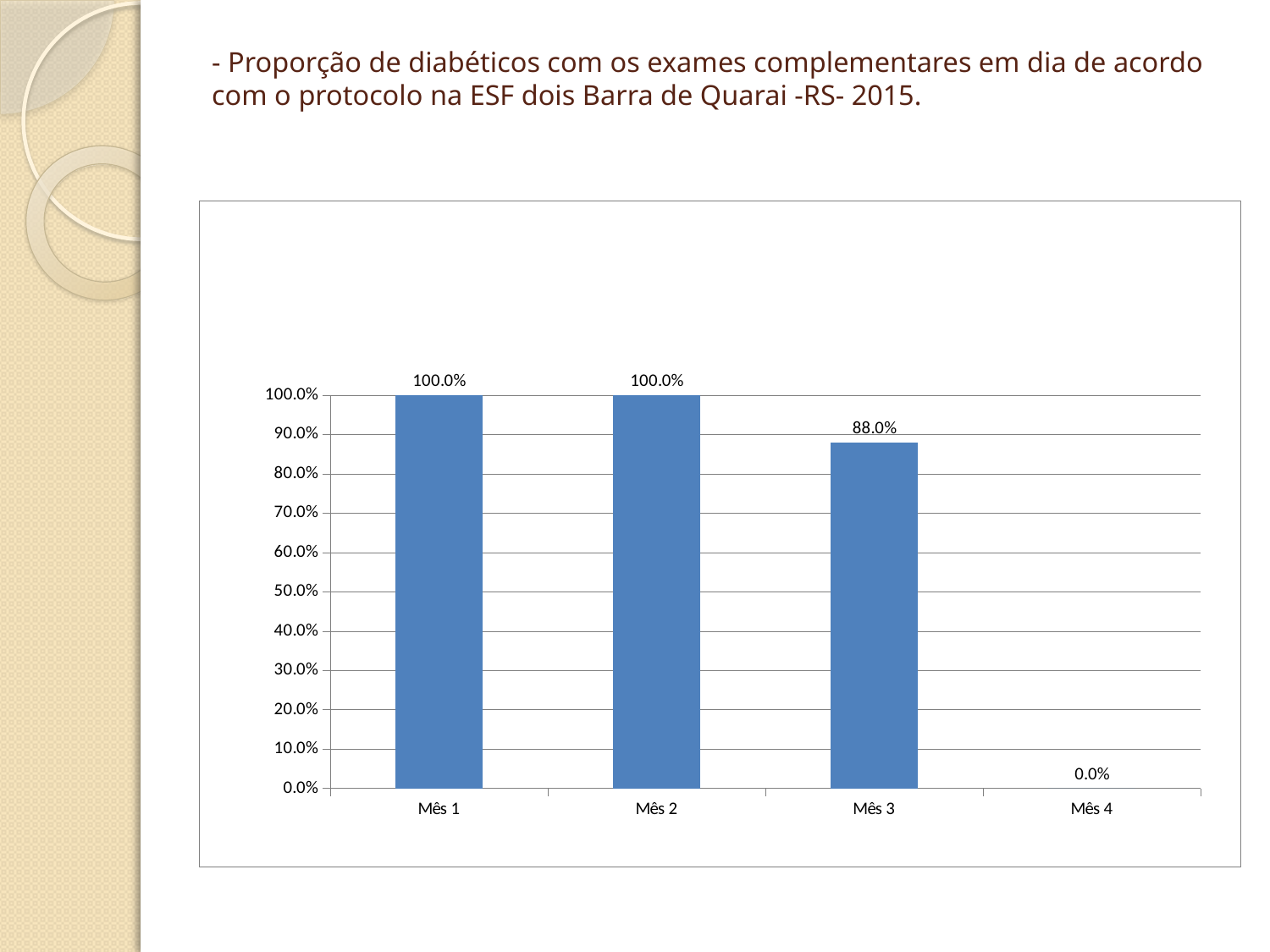
What is the value for Mês 3? 88.0% How many categories are shown on the x axis? 4 What is the difference between the values for Mês 2 and Mês 3? 12.0% Which is larger, the value for Mês 1 or the value for Mês 3? Mês 1 What is the value for Mês 1? 100.0% Do the values rise or fall from Mês 2 to Mês 4? fall Which category has the lowest value? Mês 4 Is the value for Mês 3 greater or less than 80.0%? greater What colour are the bars in the chart? blue What is the value for Mês 4? 0.0% What kind of chart is shown on the slide? bar chart What is the highest value shown on the y axis? 100.0%